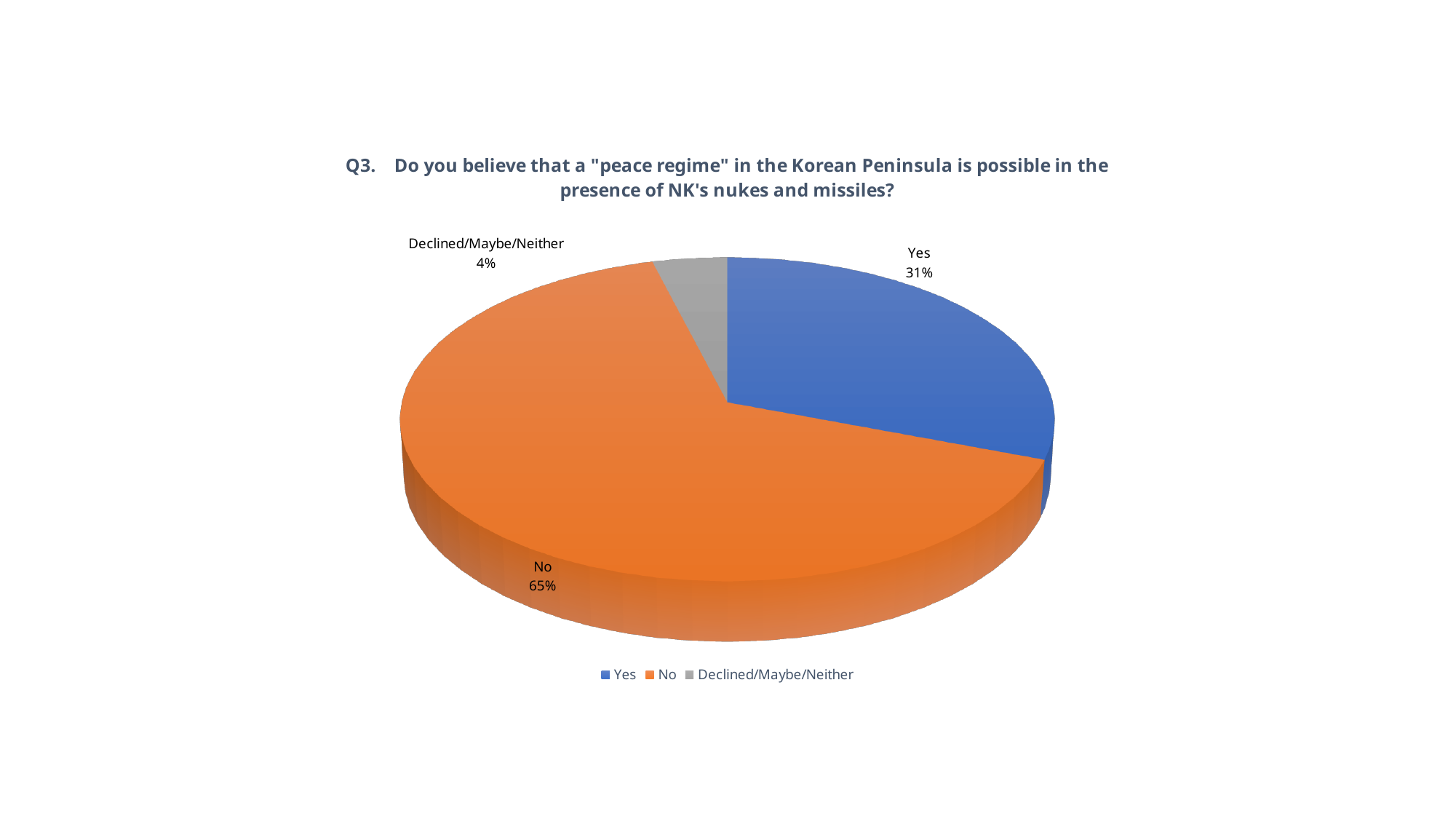
Which response has the smallest share of the pie? Declined/Maybe/Neither Which is larger, the share for "Yes" or the share for "Declined/Maybe/Neither"? Yes What kind of chart is shown on the slide? Pie chart What percentage of respondents answered "No"? 65% How many entries does the legend list? 3 How many categories are shown in the pie chart? 3 Which response has the largest share of the pie? No What colour represents the "No" response in the chart? Orange What is the question number shown at the start of the chart title? Q3 What percentage of respondents are in the "Declined/Maybe/Neither" category? 4% What percentage of respondents answered "Yes"? 31% What is the difference in percentage points between the "No" and "Yes" responses? 34